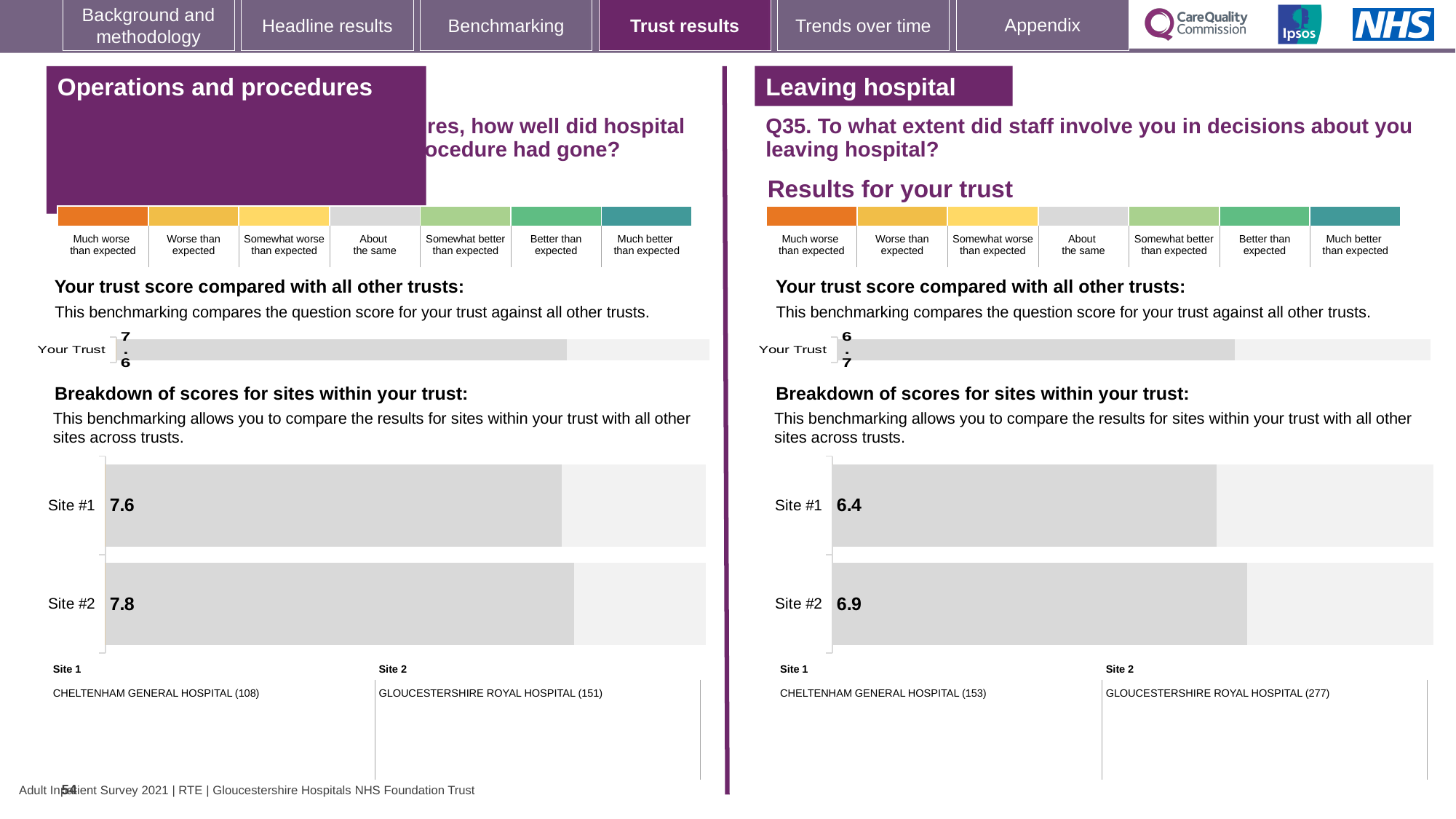
In the 'Operations and procedures' site breakdown chart on the left, what is the score for Site #1? 7.6 In the 'Operations and procedures' site breakdown chart on the left, what is the difference between the Site #2 and Site #1 scores? 0.2 In the 'Operations and procedures' 'Your Trust' chart on the left, what is the trust score? 7.6 In the 'Leaving hospital' site breakdown chart on the right, which site has the higher score? Site #2 What type of chart is the 'Operations and procedures' site breakdown chart on the left? Bar chart In the 'Leaving hospital' site breakdown chart on the right, what is the score for Site #1? 6.4 In the 'Operations and procedures' site breakdown chart on the left, which site has the lower score? Site #1 How many sites are shown in the 'Leaving hospital' site breakdown chart on the right? 2 In the 'Leaving hospital' 'Your Trust' chart on the right, what is the trust score? 6.7 In the 'Leaving hospital' site breakdown chart on the right, what is the difference between the Site #2 and Site #1 scores? 0.5 In the 'Operations and procedures' site breakdown chart on the left, what is the score for Site #2? 7.8 In the 'Leaving hospital' site breakdown chart on the right, what is the score for Site #2? 6.9